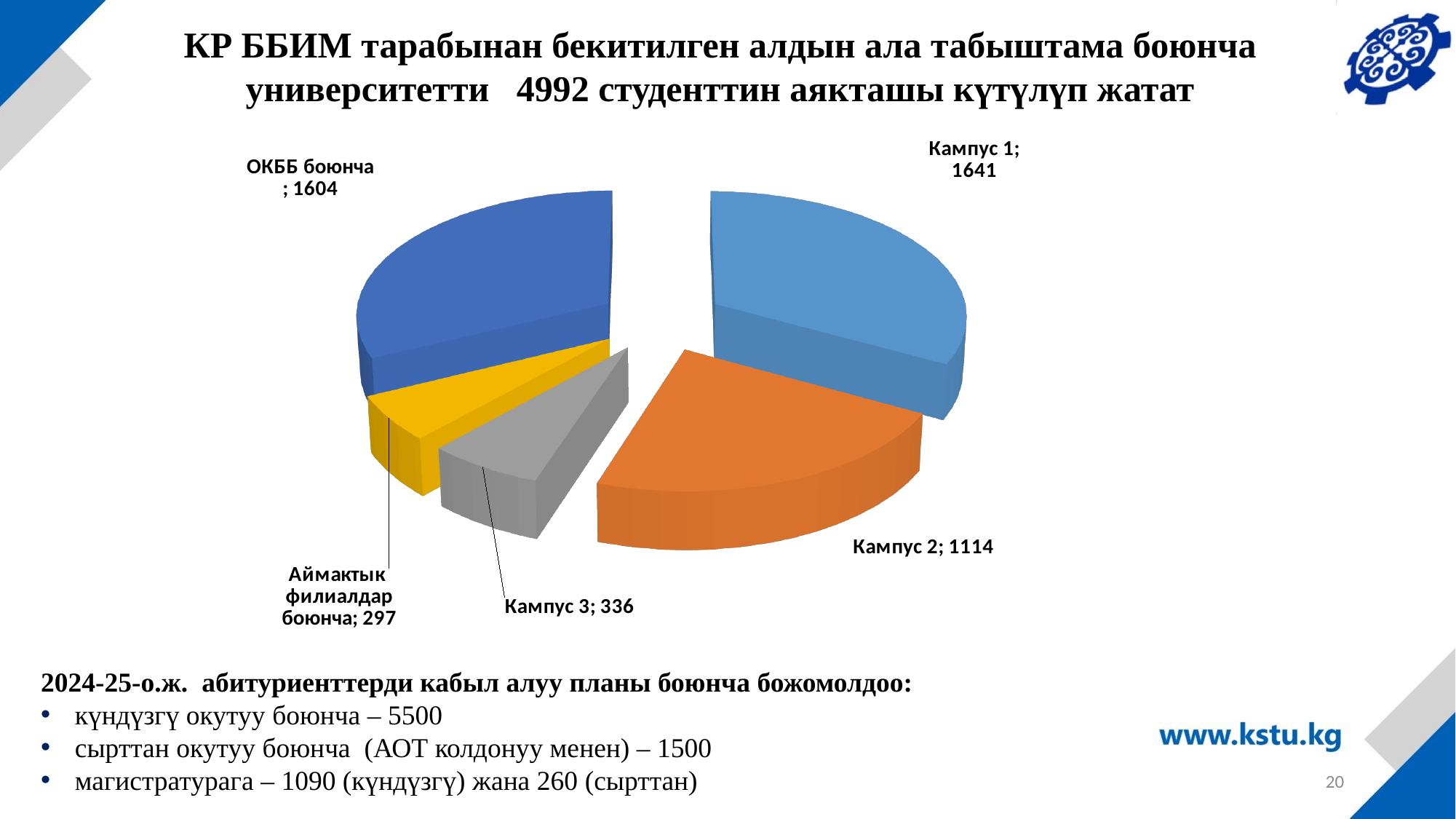
Which category has the largest value in the pie chart? Кампус 1 What is the value for Кампус 3? 336 What is the total of all slices in the pie chart? 4992 What kind of chart is shown on the slide? Pie chart How many slices does the pie chart have? 5 What is the difference between the values for Кампус 1 and ОКББ боюнча? 37 What is the value for Кампус 1? 1641 Which is larger, the value for Кампус 2 or the value for Кампус 3? Кампус 2 What is the value for Кампус 2? 1114 What is the value for Аймактык филиалдар боюнча? 297 What is the value for ОКББ боюнча? 1604 Which category has the smallest value in the pie chart? Аймактык филиалдар боюнча